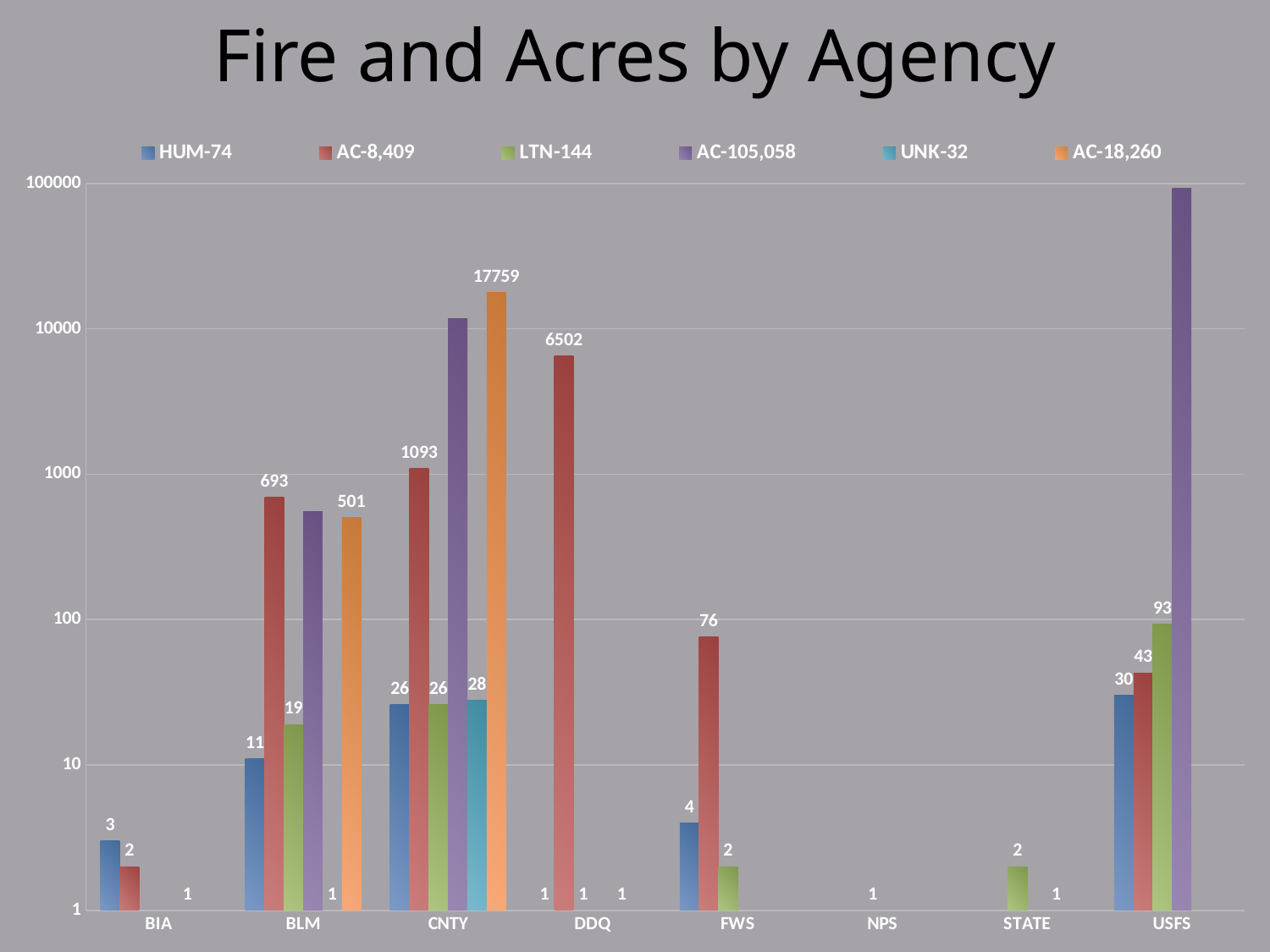
What is the AC-8,409 value for DDQ? 6502 What kind of chart is shown on the slide? bar chart What is the difference between the AC-8,409 values for CNTY and BLM? 400 What is the LTN-144 value for USFS? 93 What is the AC-18,260 value for BLM? 501 Which agency has the highest AC-8,409 value? DDQ Which agency has the highest HUM-74 value? USFS Is the AC-105,058 value for USFS greater or less than 10000? greater What is the AC-18,260 value for CNTY? 17759 How many agency categories are shown on the x axis? 8 How many series does the legend list? 6 Which is larger, the HUM-74 value for BLM or for FWS? BLM